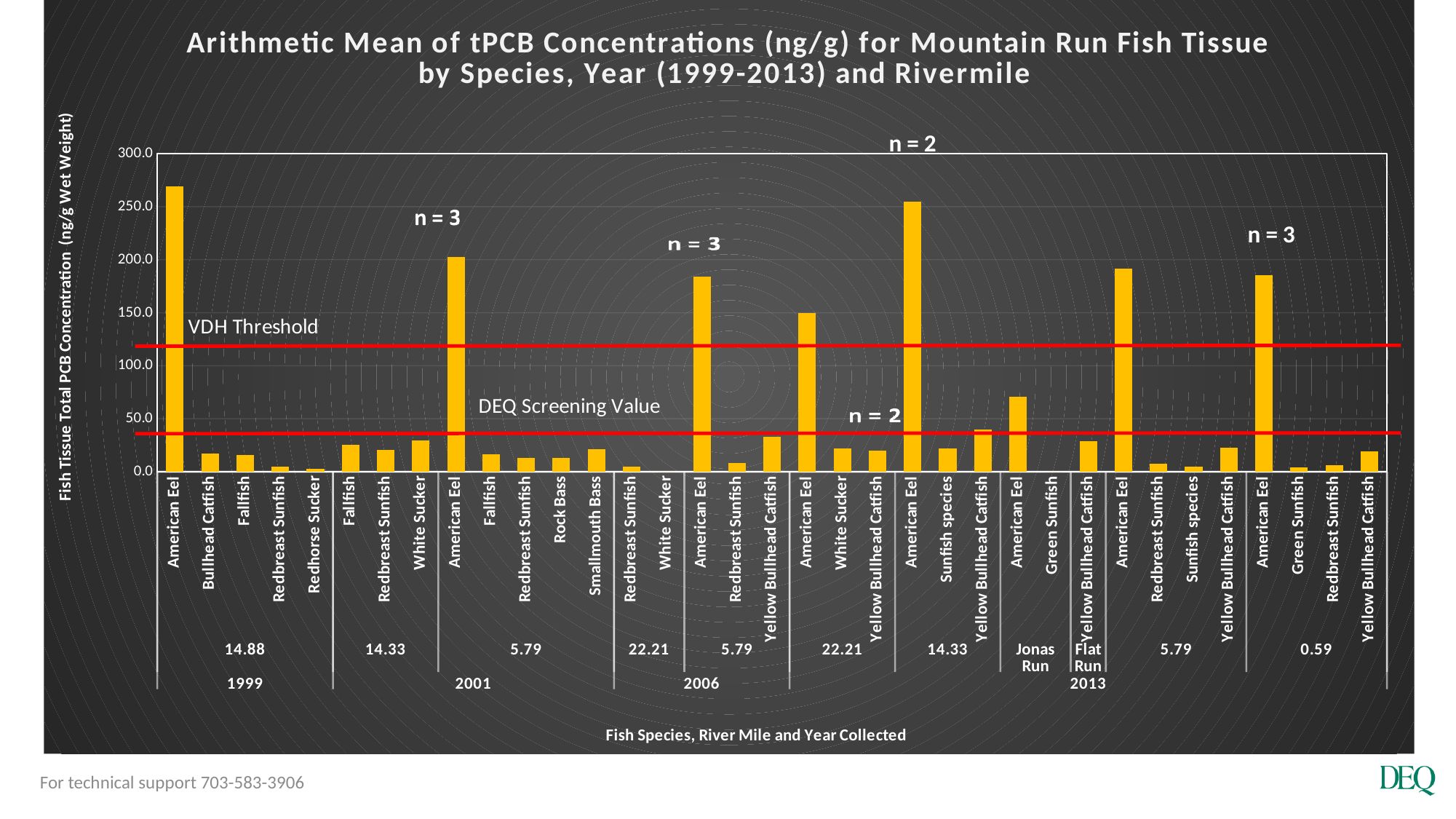
Is the value for American Eel at rivermile 5.79 in 2001 greater or less than 150? greater Which is larger: the American Eel value at rivermile 14.33 in 2013 or the American Eel value at rivermile 22.21 in 2013? rivermile 14.33 in 2013 How many bars are in the 1999 group? 5 How many year groups are shown along the x axis? 4 Is the value for American Eel at rivermile 22.21 in 2013 greater or less than 200? less What kind of chart is shown on the slide? bar chart Which bar is the highest on the chart? American Eel, rivermile 14.88, 1999 Is the value for American Eel at rivermile 14.88 in 1999 greater or less than 250? greater Which is larger: the Fallfish value at rivermile 14.33 in 2001 or the Fallfish value at rivermile 5.79 in 2001? rivermile 14.33 in 2001 What does the upper red horizontal line represent? VDH Threshold